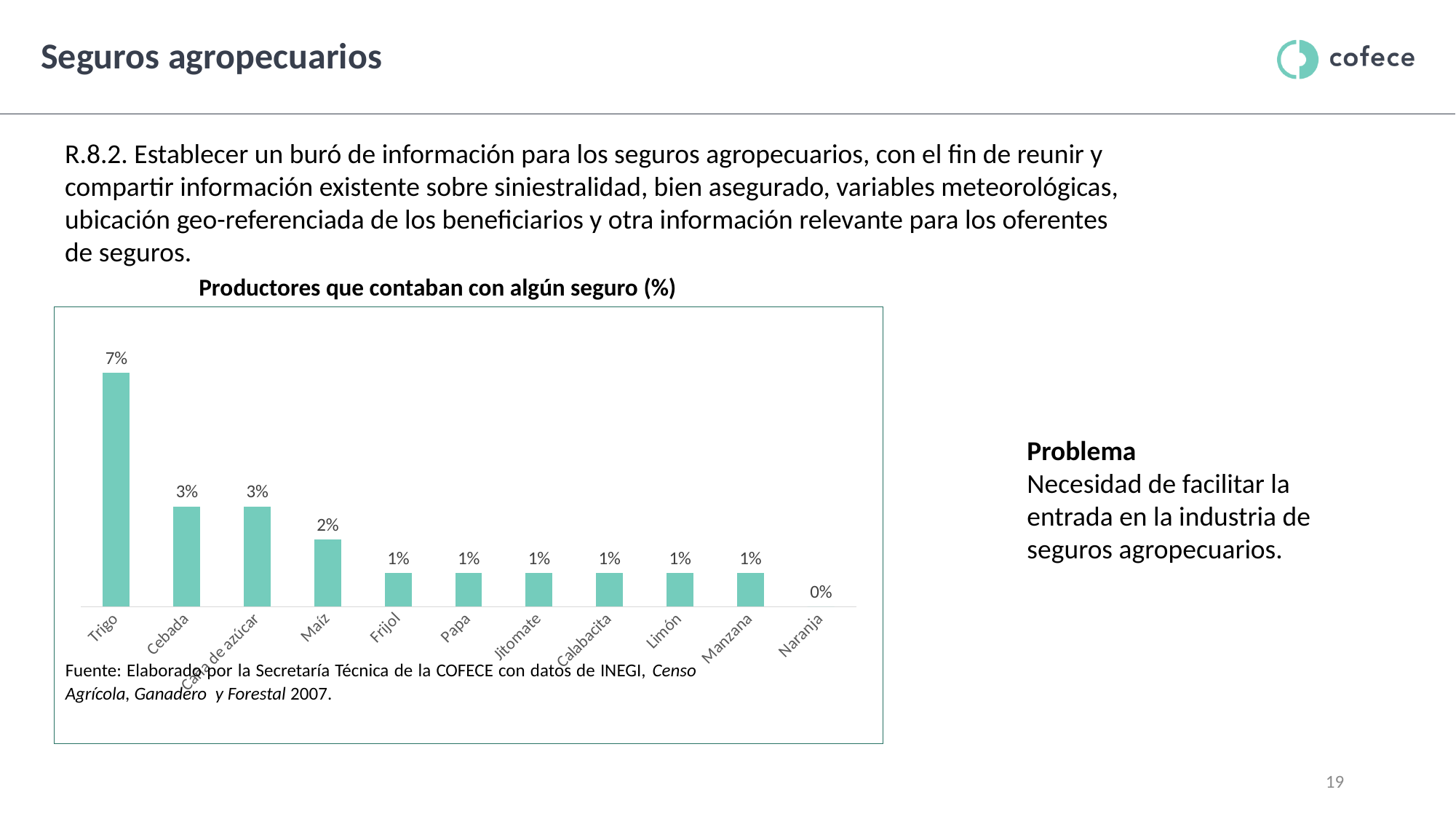
How many categories are shown on the x axis? 11 What is the difference between the values for Maíz and Frijol? 1% What is the value for Naranja? 0% Which category has the highest value? Trigo What is the difference between the values for Trigo and Cebada? 4% Which category has the lowest value? Naranja What kind of chart is shown on the slide? Bar chart What is the value for Maíz? 2% Which is larger, the value for Caña de azúcar or the value for Maíz? Caña de azúcar What is the title of the chart? Productores que contaban con algún seguro (%) What is the value for Trigo? 7% What is the value for Cebada? 3%